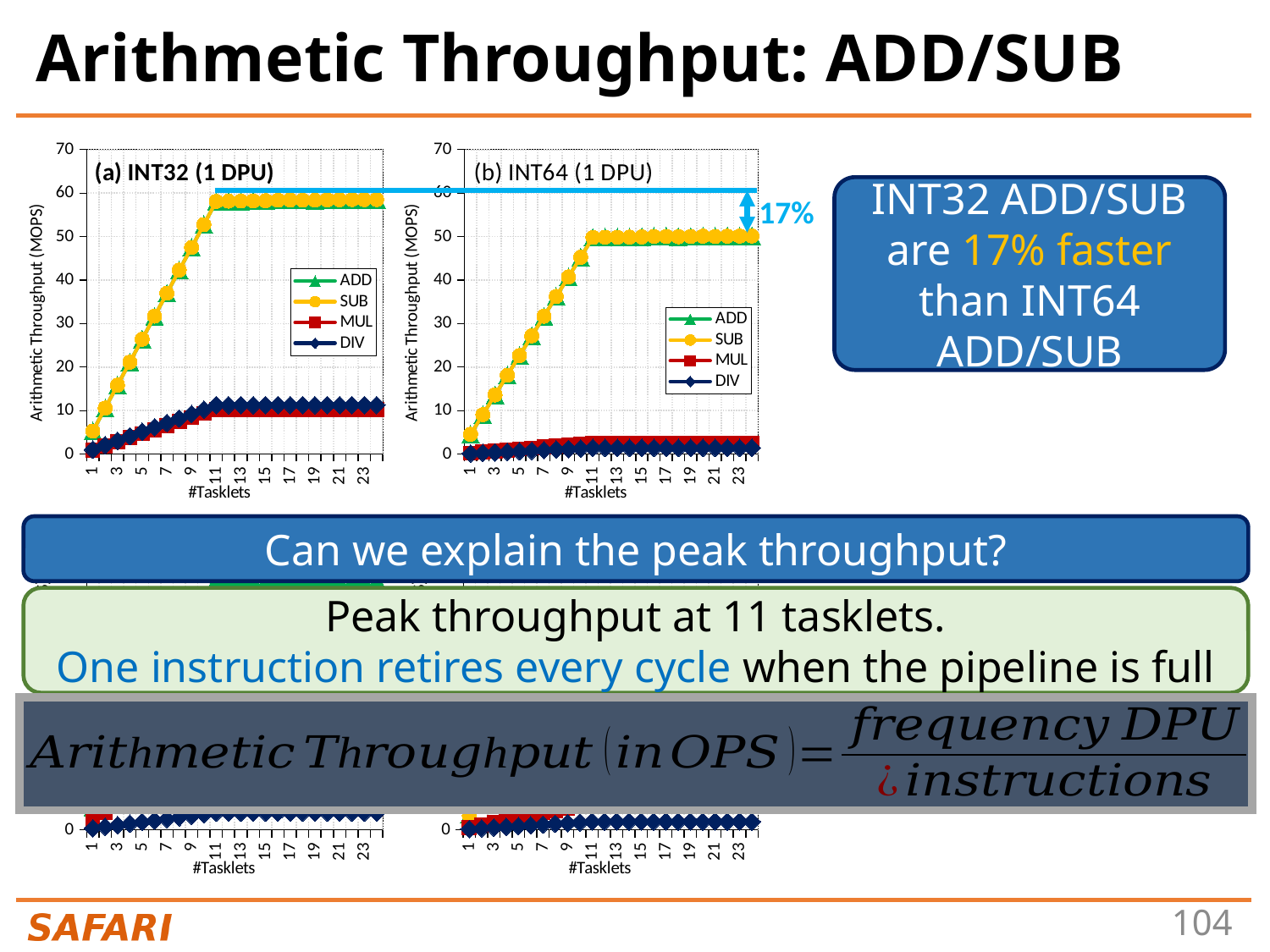
What is the y-axis label of chart (a) INT32 (1 DPU)? Arithmetic Throughput (MOPS) In chart (b) INT64 (1 DPU), is the MUL value at 23 tasklets greater or less than 10? less In chart (a) INT32 (1 DPU), how many series does the legend list? 4 In chart (b) INT64 (1 DPU), what are the legend entries? ADD, SUB, MUL, DIV In chart (a) INT32 (1 DPU), at 23 tasklets, which is larger: ADD or MUL? ADD In chart (b) INT64 (1 DPU), which series has the lowest value at 23 tasklets: SUB or DIV? DIV At 23 tasklets, is the ADD throughput higher in chart (a) INT32 (1 DPU) or chart (b) INT64 (1 DPU)? (a) INT32 (1 DPU) In chart (a) INT32 (1 DPU), is the DIV value at 23 tasklets greater or less than 20? less In chart (b) INT64 (1 DPU), is the ADD value at 23 tasklets greater or less than 60? less In chart (a) INT32 (1 DPU), does the ADD series rise or fall as the number of tasklets goes from 1 to 11? rise What kind of chart is chart (a) INT32 (1 DPU)? line chart